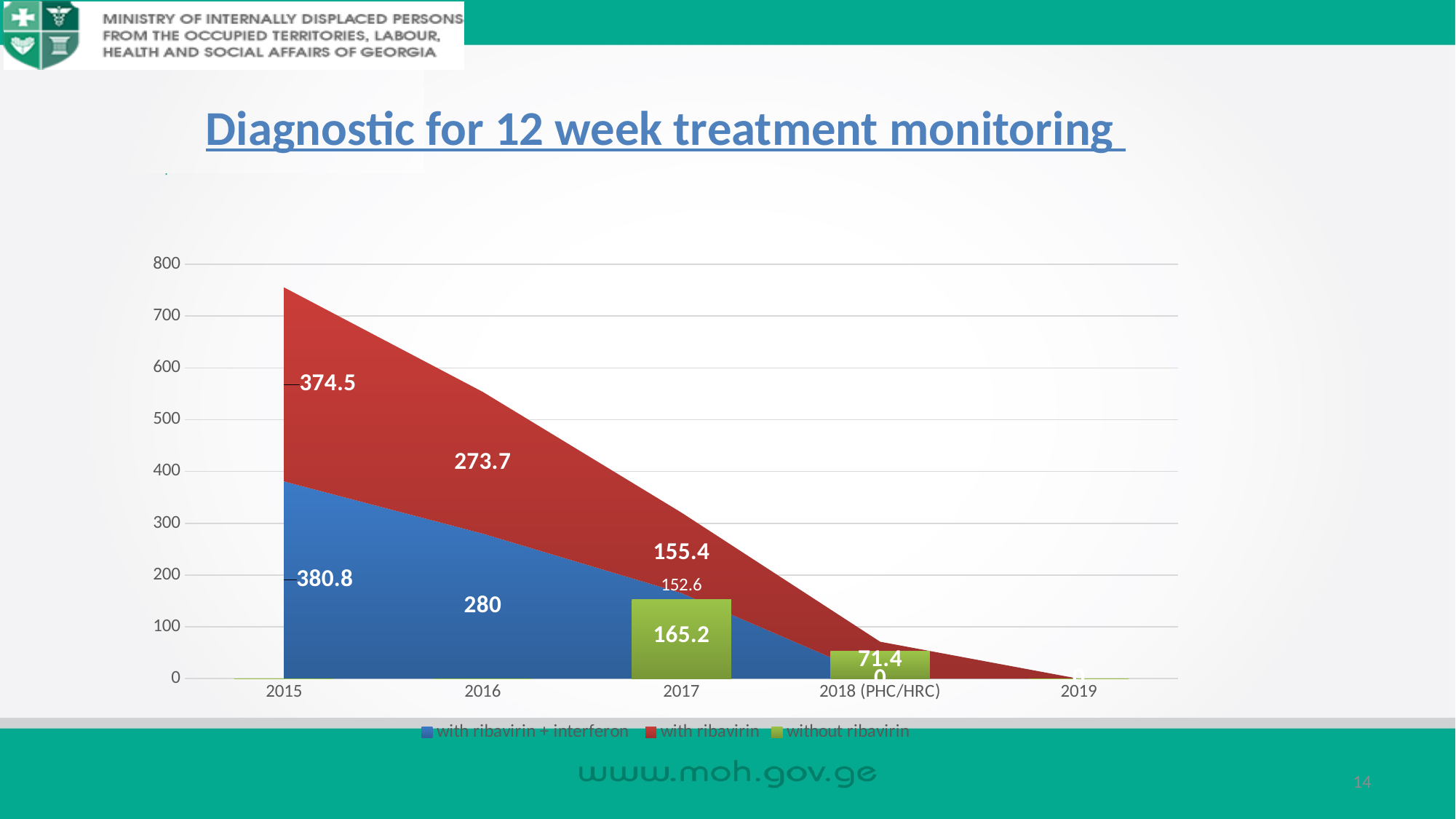
What is the difference between the 'with ribavirin + interferon' and 'with ribavirin' values in 2015? 6.3 Does the 'with ribavirin + interferon' value rise or fall from 2015 to 2017? fall In 2016, which is larger: 'with ribavirin + interferon' or 'with ribavirin'? with ribavirin + interferon What is the value for 'with ribavirin' in 2017? 155.4 What is the value for 'with ribavirin' in 2016? 273.7 How many year categories are shown on the x axis? 5 How many series does the legend list? 3 What is the value for 'with ribavirin' in 2015? 374.5 What is the value for 'without ribavirin' in 2017? 152.6 What is the value for 'with ribavirin + interferon' in 2015? 380.8